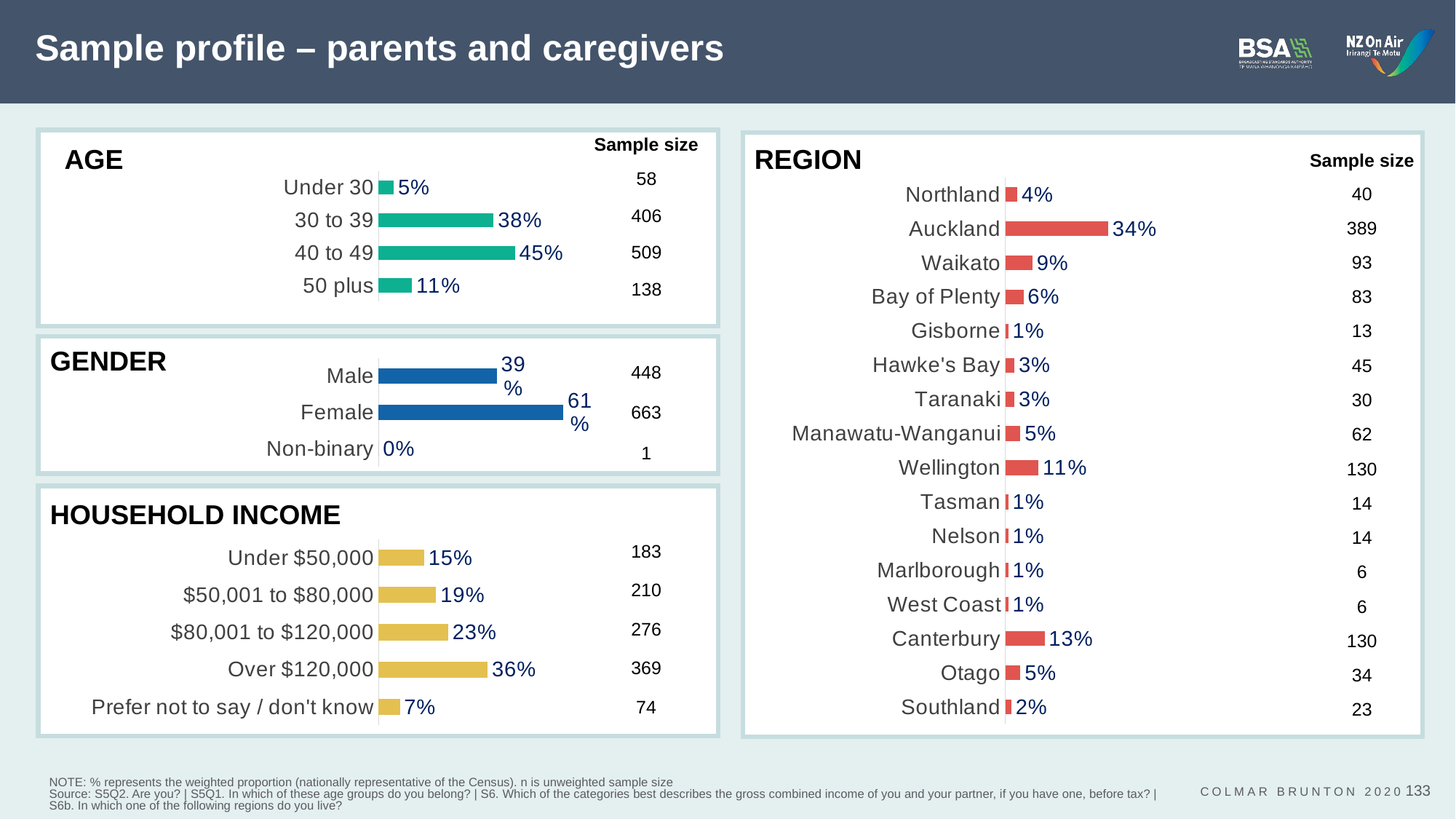
In the AGE chart, which age group has the lowest percentage? Under 30 In the AGE chart, what is the difference in percentage points between the 40 to 49 and 30 to 39 groups? 7 In the HOUSEHOLD INCOME chart, what percentage is shown for $50,001 to $80,000? 19% In the AGE chart, what percentage is shown for the 40 to 49 group? 45% In the REGION chart, which region has the highest percentage? Auckland In the HOUSEHOLD INCOME chart, which category has the highest percentage? Over $120,000 In the GENDER chart, how many categories are shown? 3 In the REGION chart, what percentage is shown for Auckland? 34% In the HOUSEHOLD INCOME chart, which is larger: Under $50,000 or $80,001 to $120,000? $80,001 to $120,000 In the REGION chart, how many regions are listed? 16 What type of chart is the REGION chart? Bar chart In the GENDER chart, what percentage is shown for Female? 61%